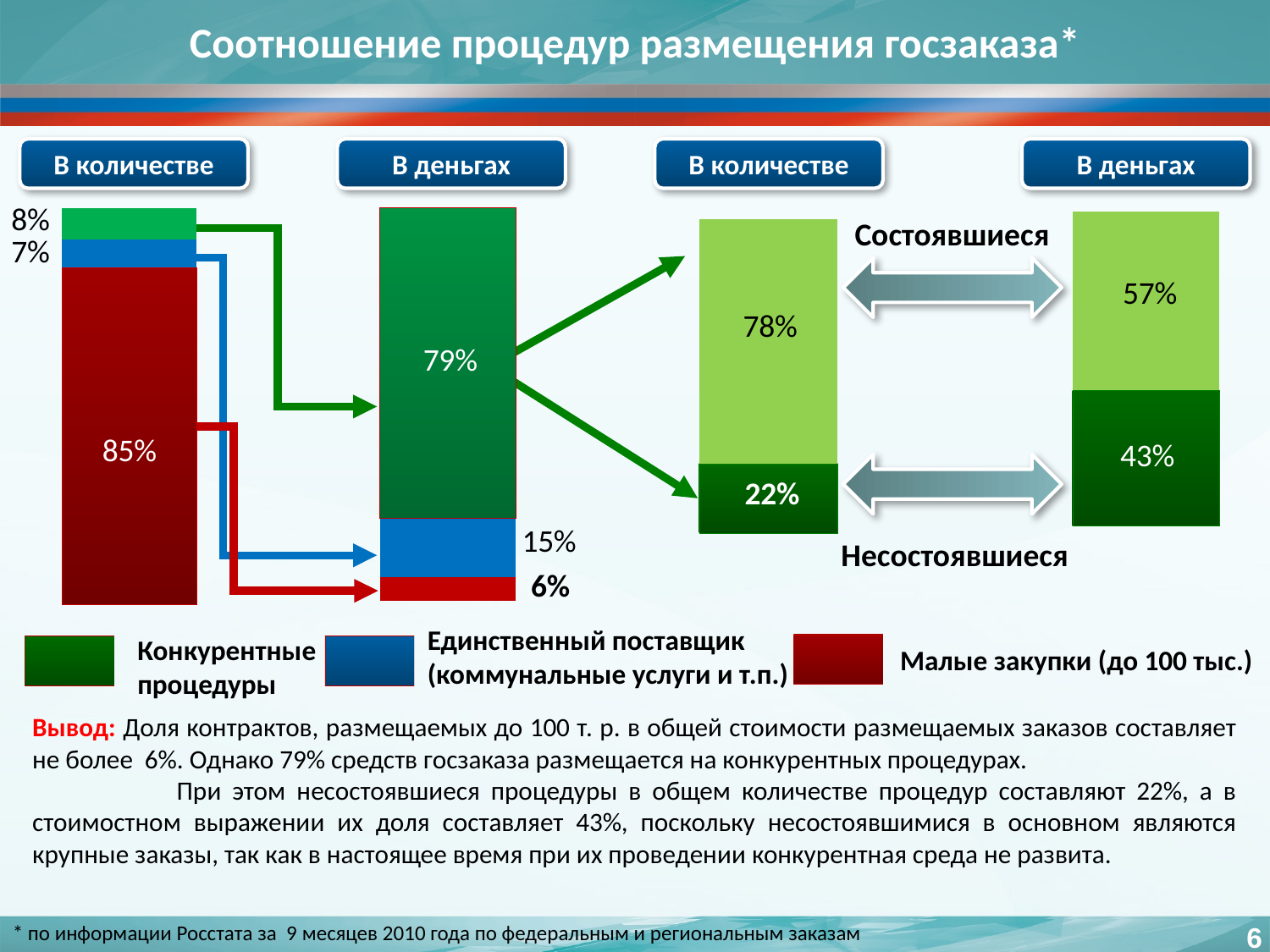
In the rightmost bar (second 'В деньгах'), what share do the failed procedures (Несостоявшиеся) have? 43% In the second bar from the left (first 'В деньгах'), what share do competitive procedures have? 79% In the second bar from the left (first 'В деньгах'), what share do small purchases have? 6% In the leftmost bar (first 'В количестве'), what share do small purchases (Малые закупки) have? 85% In the leftmost bar (first 'В количестве'), which category has the largest share? Малые закупки (до 100 тыс.) In the leftmost bar (first 'В количестве'), what share do competitive procedures (Конкурентные процедуры) have? 8% In the rightmost bar (second 'В деньгах'), what share do the completed procedures (Состоявшиеся) have? 57% In the second bar from the left (first 'В деньгах'), what share does the single supplier (Единственный поставщик) category have? 15% How many categories does the legend at the bottom of the slide list? 3 In the second bar from the left (first 'В деньгах'), which category has the smallest share? Малые закупки (до 100 тыс.) In the third bar from the left (second 'В количестве'), what share do the failed procedures (Несостоявшиеся) have? 22% What is the difference between the share of competitive procedures in the first 'В деньгах' bar and in the first 'В количестве' bar? 71%